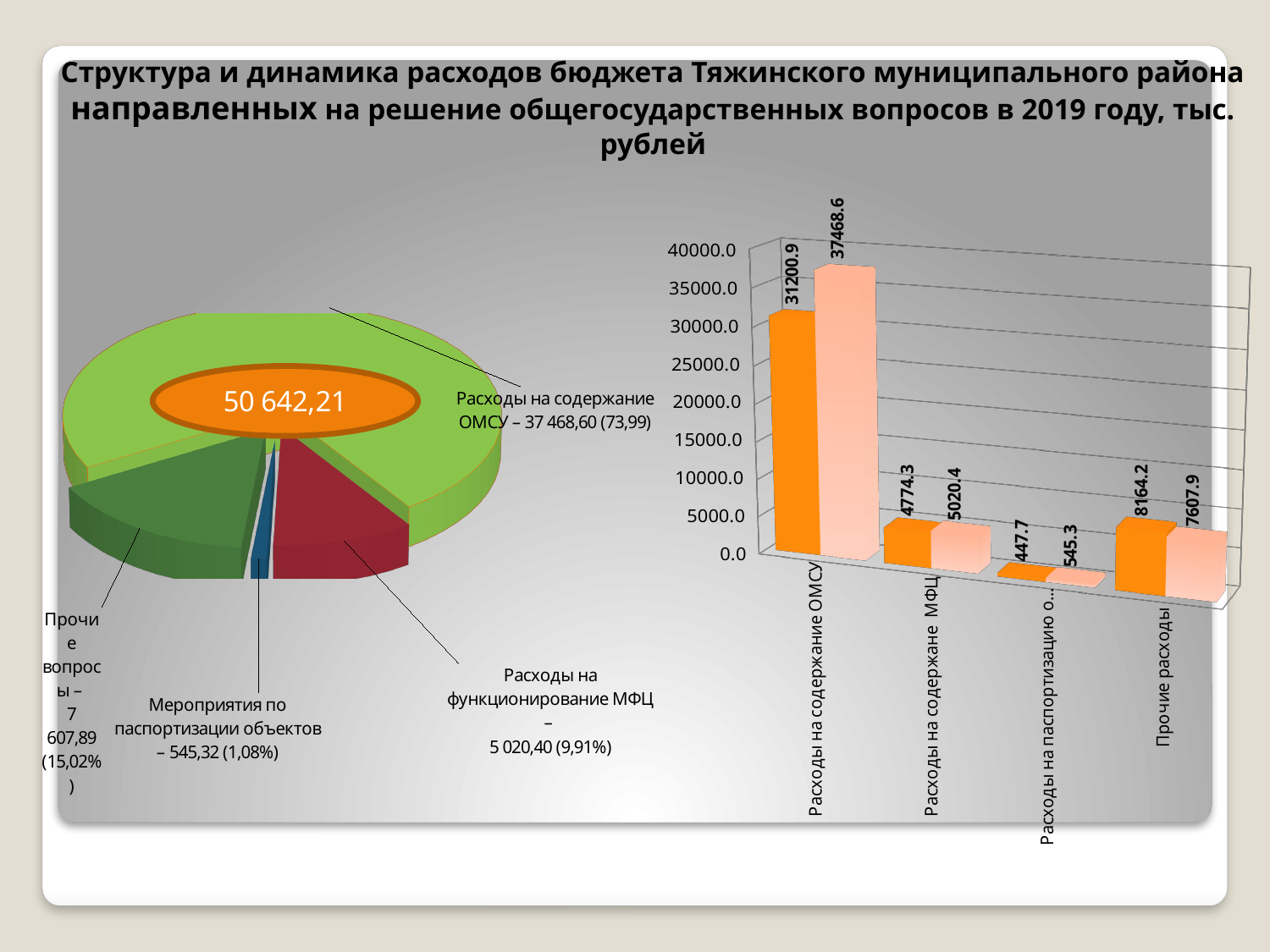
What kind of chart is shown on the right side of the slide? Bar chart On the bar chart on the right, for Прочие расходы, which bar is larger: the orange bar or the light-coloured bar? The orange bar On the bar chart on the right, what is the value of the light-coloured bar for Прочие расходы? 7607.9 On the pie chart on the left, what total value is printed in the centre of the pie? 50 642,21 On the bar chart on the right, what is the difference between the two bars for Расходы на содержане МФЦ? 246.1 On the bar chart on the right, what is the value of the orange bar for Расходы на содержание ОМСУ? 31200.9 On the pie chart on the left, what share of the total is Расходы на функционирование МФЦ? 9,91% On the pie chart on the left, what share of the total is Прочие вопросы? 15,02% On the bar chart on the right, how many categories are shown on the x axis? 4 On the bar chart on the right, which category has the highest values? Расходы на содержание ОМСУ On the pie chart on the left, which category has the smallest slice? Мероприятия по паспортизации объектов On the pie chart on the left, what value is shown for Расходы на содержание ОМСУ? 37 468,60